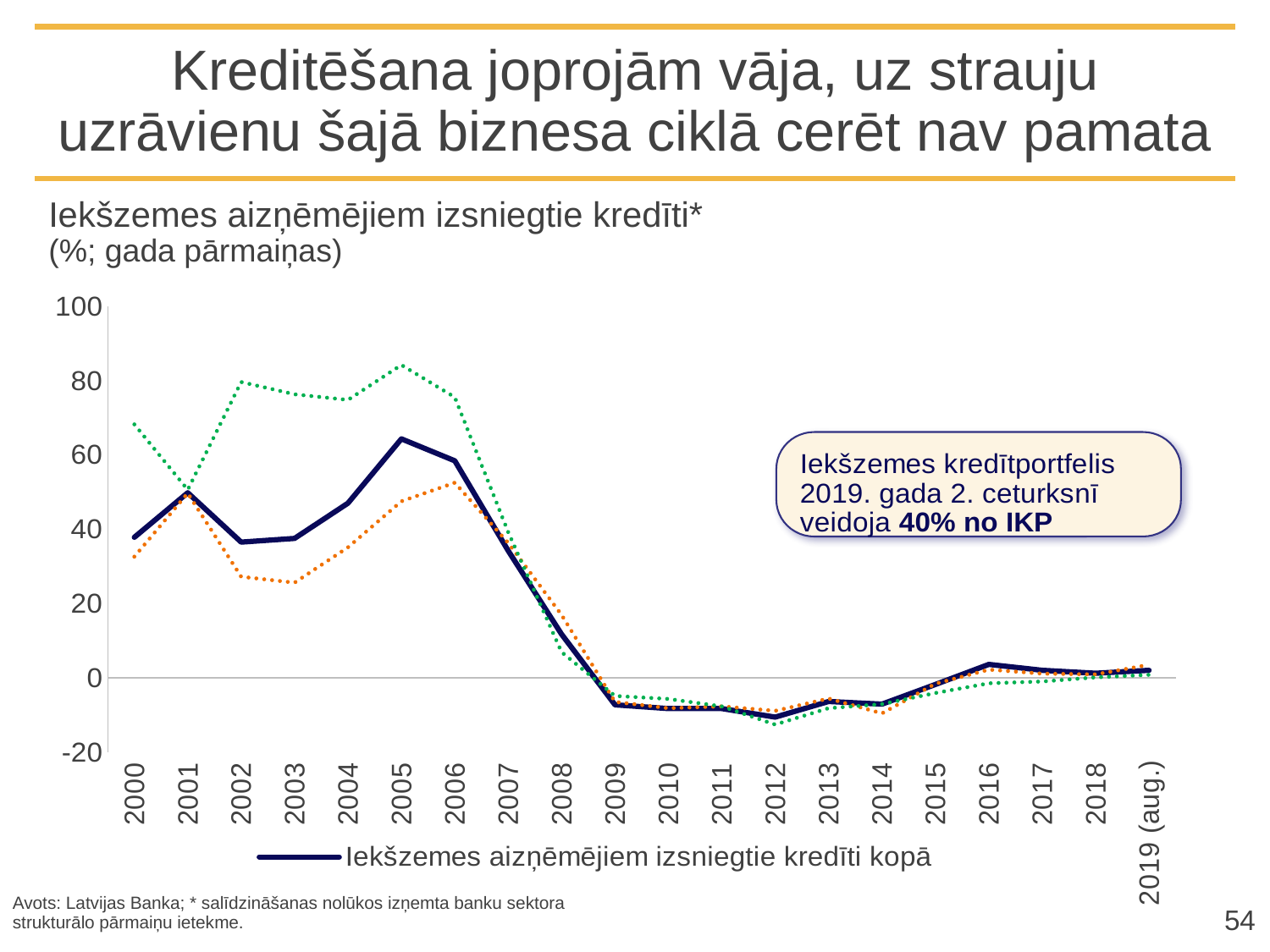
How many series does the chart's legend list? 1 What kind of chart is shown on the slide? line chart Is the value of the solid line 'Iekšzemes aizņēmējiem izsniegtie kredīti kopā' in 2005 greater or less than 40? greater Is the value of the green dotted line in 2002 greater or less than 60? greater What is the title of the chart on the slide? Iekšzemes aizņēmējiem izsniegtie kredīti* (%; gada pārmaiņas) Is the value of the orange dotted line in 2002 greater or less than 40? less According to the callout box on the chart, what share of GDP (IKP) did the domestic credit portfolio make up in Q2 2019? 40% no IKP How many years (categories) are shown along the x axis of the chart? 20 In which year does the solid line 'Iekšzemes aizņēmējiem izsniegtie kredīti kopā' reach its highest value? 2005 For the solid line 'Iekšzemes aizņēmējiem izsniegtie kredīti kopā', which year has the larger value, 2001 or 2005? 2005 Does the solid line 'Iekšzemes aizņēmējiem izsniegtie kredīti kopā' rise or fall between 2006 and 2009? fall